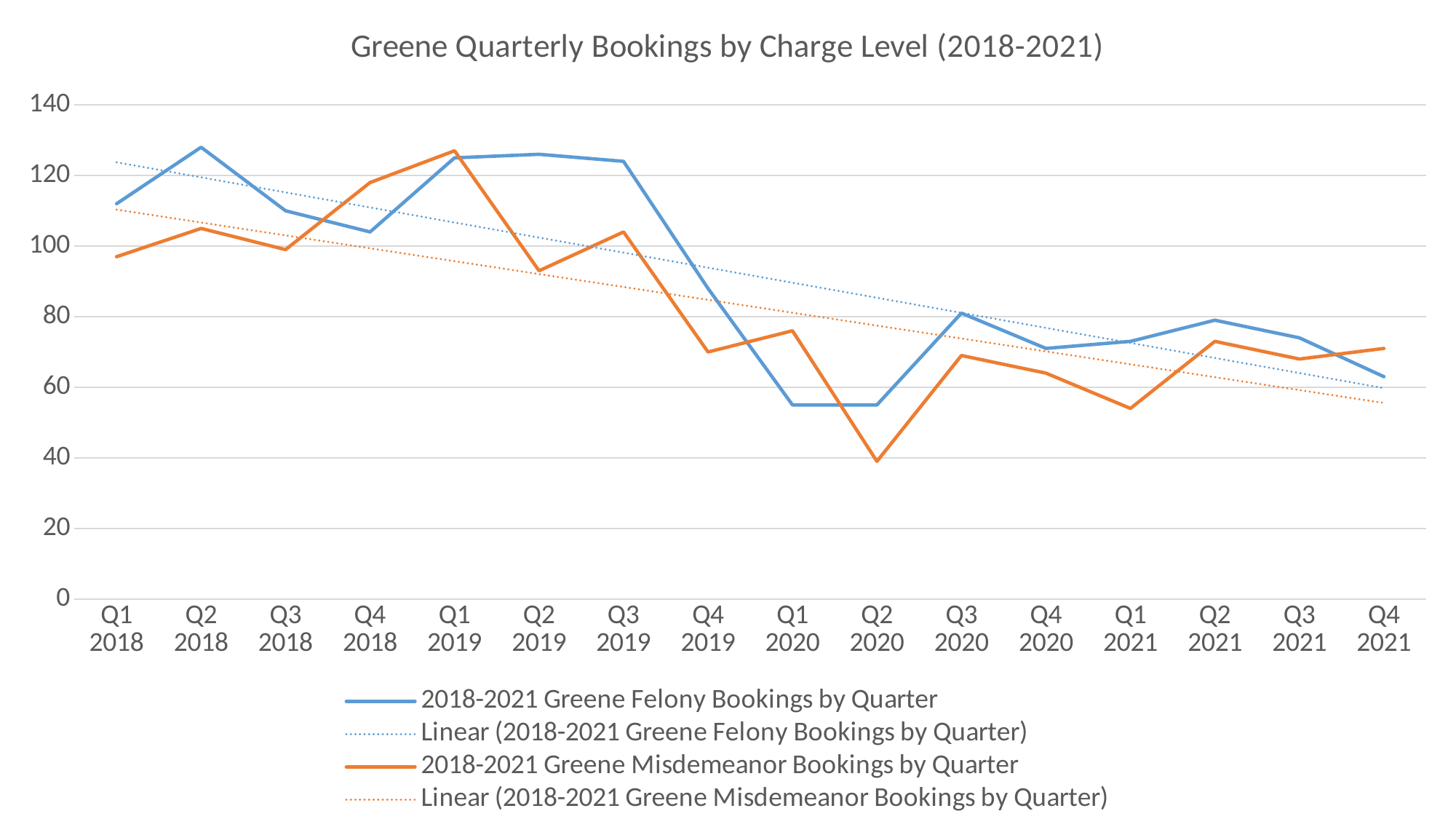
Is the value for Greene Felony Bookings in Q2 2020 greater or less than 60? less Is the value for Greene Misdemeanor Bookings in Q4 2019 greater or less than 80? less Do the dotted linear trendlines rise or fall from left to right? Fall Is the value for Greene Misdemeanor Bookings in Q1 2019 greater or less than 120? greater In Q1 2018, which is larger: Felony Bookings or Misdemeanor Bookings? Felony Bookings What is the title of the chart? Greene Quarterly Bookings by Charge Level (2018-2021) How many entries does the legend list? 4 In Q4 2018, which is larger: Felony Bookings or Misdemeanor Bookings? Misdemeanor Bookings What kind of chart is shown on the slide? Line chart How many quarters are plotted along the x axis? 16 In which quarter is the Greene Misdemeanor Bookings line at its highest? Q1 2019 In which quarter is the Greene Misdemeanor Bookings line at its lowest? Q2 2020